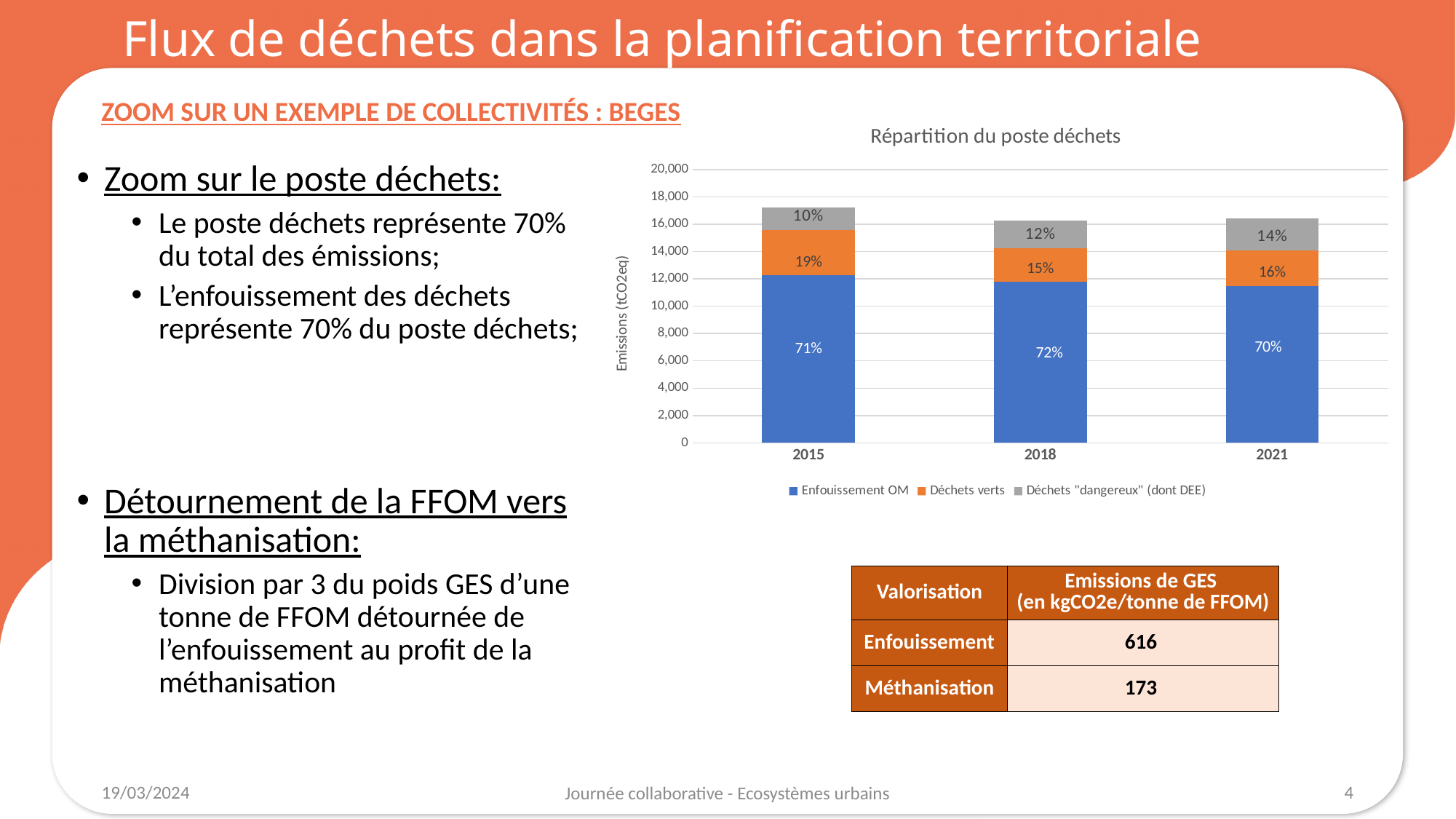
In the chart "Répartition du poste déchets", is the Enfouissement OM percentage larger in 2018 or in 2021? 2018 How many series does the legend of the chart "Répartition du poste déchets" list? 3 In the chart "Répartition du poste déchets", which year has the lowest percentage for Déchets verts? 2018 In the chart "Répartition du poste déchets", does the percentage for Déchets "dangereux" (dont DEE) rise or fall from 2015 to 2021? Rise In the chart "Répartition du poste déchets", what percentage is shown for Déchets "dangereux" (dont DEE) in 2021? 14% In the chart "Répartition du poste déchets", what is the difference in percentage points between Déchets verts in 2015 and in 2018? 4 percentage points In the chart "Répartition du poste déchets", is the total height of the 2015 bar greater or less than 16,000? greater In the chart "Répartition du poste déchets", which year has the highest percentage for Déchets "dangereux" (dont DEE)? 2021 In the chart "Répartition du poste déchets", what percentage is shown for Enfouissement OM in 2015? 71% How many years are shown on the x axis of the chart "Répartition du poste déchets"? 3 In the chart "Répartition du poste déchets", what percentage is shown for Déchets verts in 2018? 15% What kind of chart is "Répartition du poste déchets"? Stacked bar chart